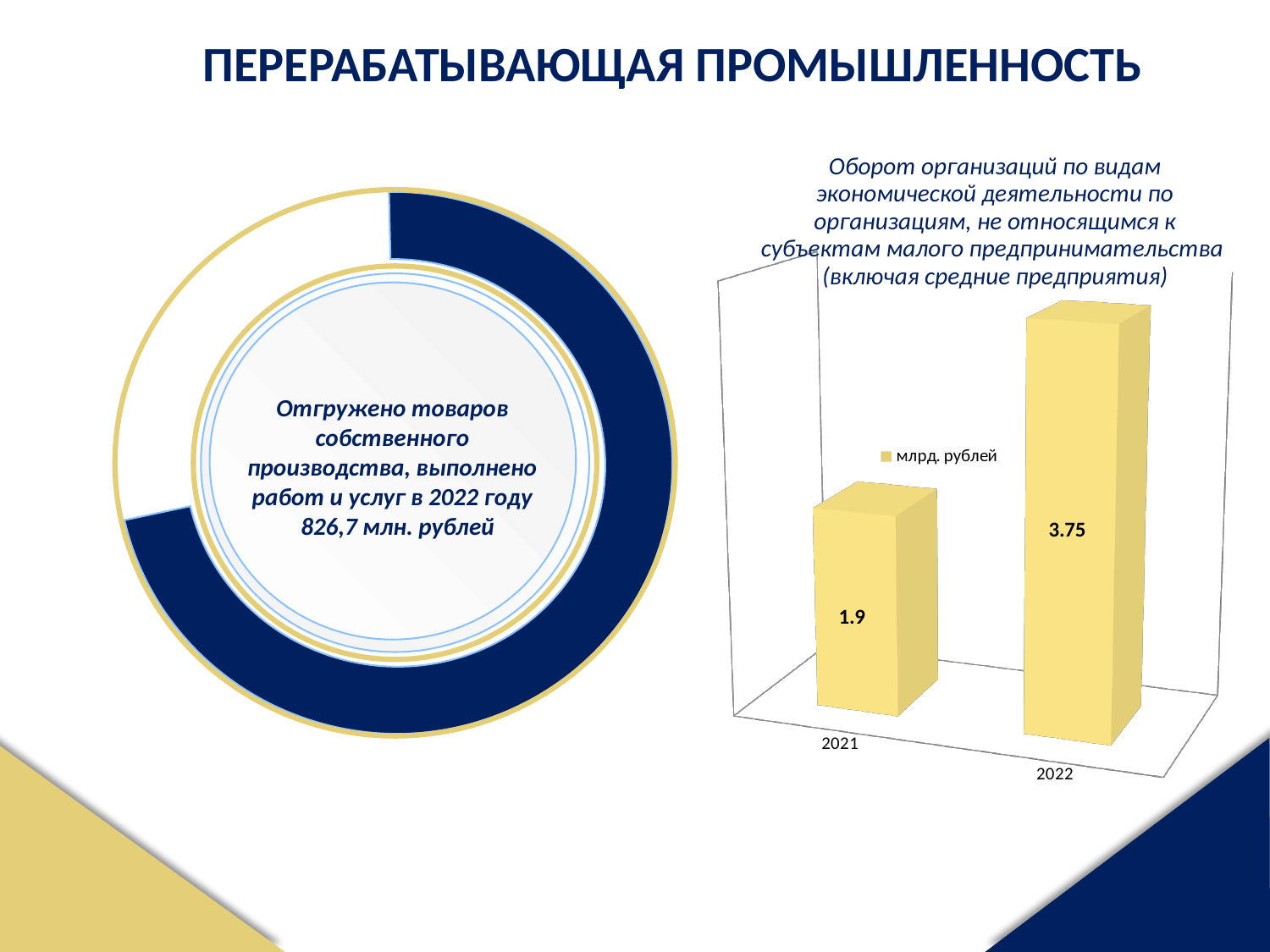
What kind of chart is shown on the right side of the slide? bar chart In the bar chart, which year has the higher value? 2022 In the bar chart, is the value for 2022 larger or smaller than the value for 2021? larger How many bars are shown in the bar chart? 2 In the bar chart, what is the difference between the 2022 and 2021 values? 1.85 In the bar chart, which year has the lower value? 2021 In the bar chart, what is the value for 2021? 1.9 How many series does the legend of the bar chart list? 1 What colour are the bars in the bar chart? yellow In the bar chart, what is the value for 2022? 3.75 In the bar chart, do the values rise or fall from 2021 to 2022? rise What is the legend entry of the bar chart? млрд. рублей